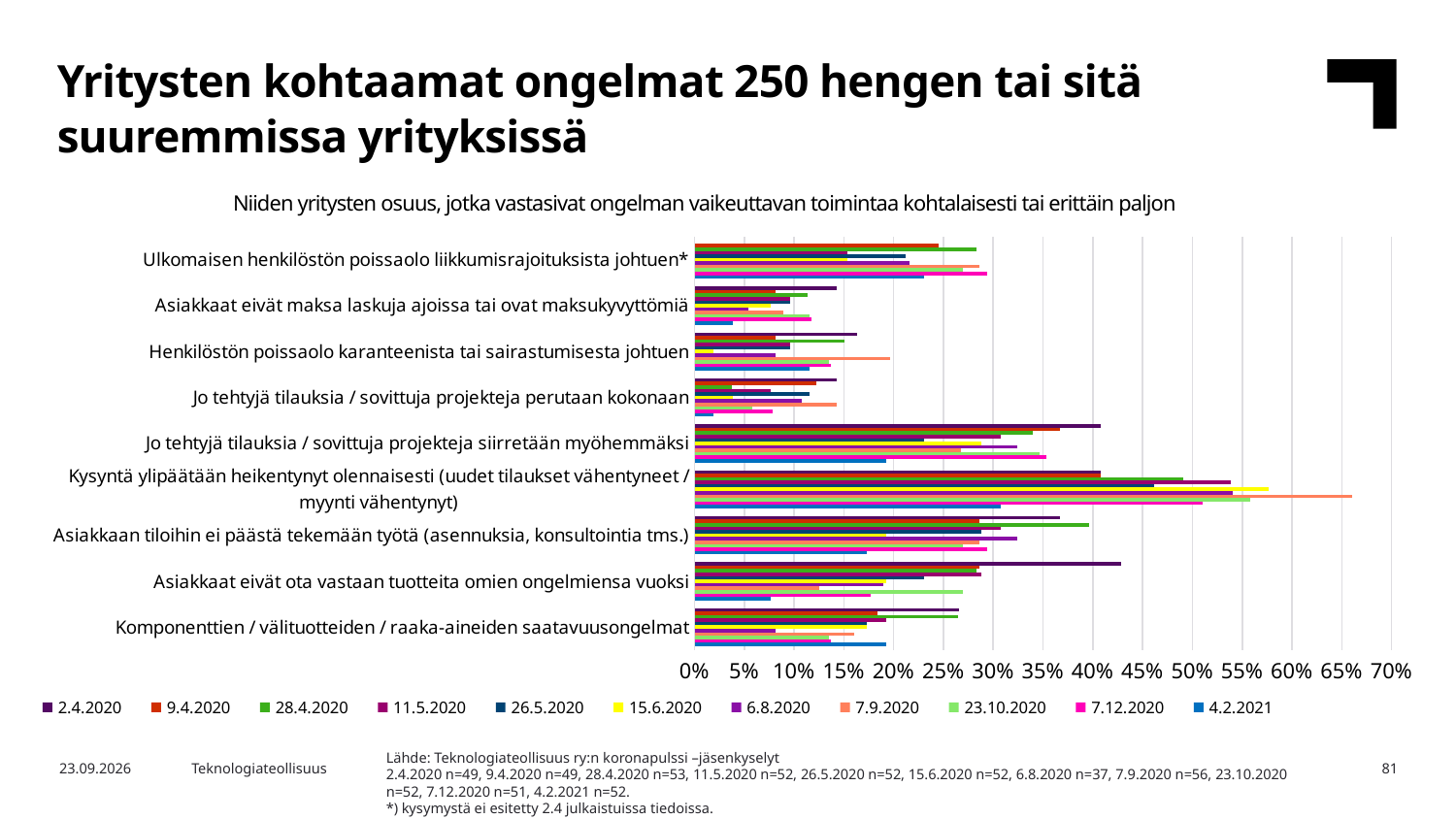
How many series does the chart legend list? 11 What is the highest value shown on the horizontal axis of the chart? 70% How many categories (problem types) are listed on the vertical axis of the chart? 9 Which category has the longest bar in the chart overall? Kysyntä ylipäätään heikentynyt olennaisesti (uudet tilaukset vähentyneet / myynti vähentynyt) Which date is the last entry in the chart legend? 4.2.2021 For the 2.4.2020 series, which is larger: the value for 'Kysyntä ylipäätään heikentynyt olennaisesti' or for 'Komponenttien / välituotteiden / raaka-aineiden saatavuusongelmat'? Kysyntä ylipäätään heikentynyt olennaisesti Is the 7.9.2020 value for 'Kysyntä ylipäätään heikentynyt olennaisesti' greater or less than 60%? greater Is the 2.4.2020 value for 'Asiakkaat eivät ota vastaan tuotteita omien ongelmiensa vuoksi' greater or less than 40%? greater What kind of chart is shown on the slide? bar chart Is the 4.2.2021 value for 'Ulkomaisen henkilöstön poissaolo liikkumisrajoituksista johtuen*' greater or less than 20%? greater